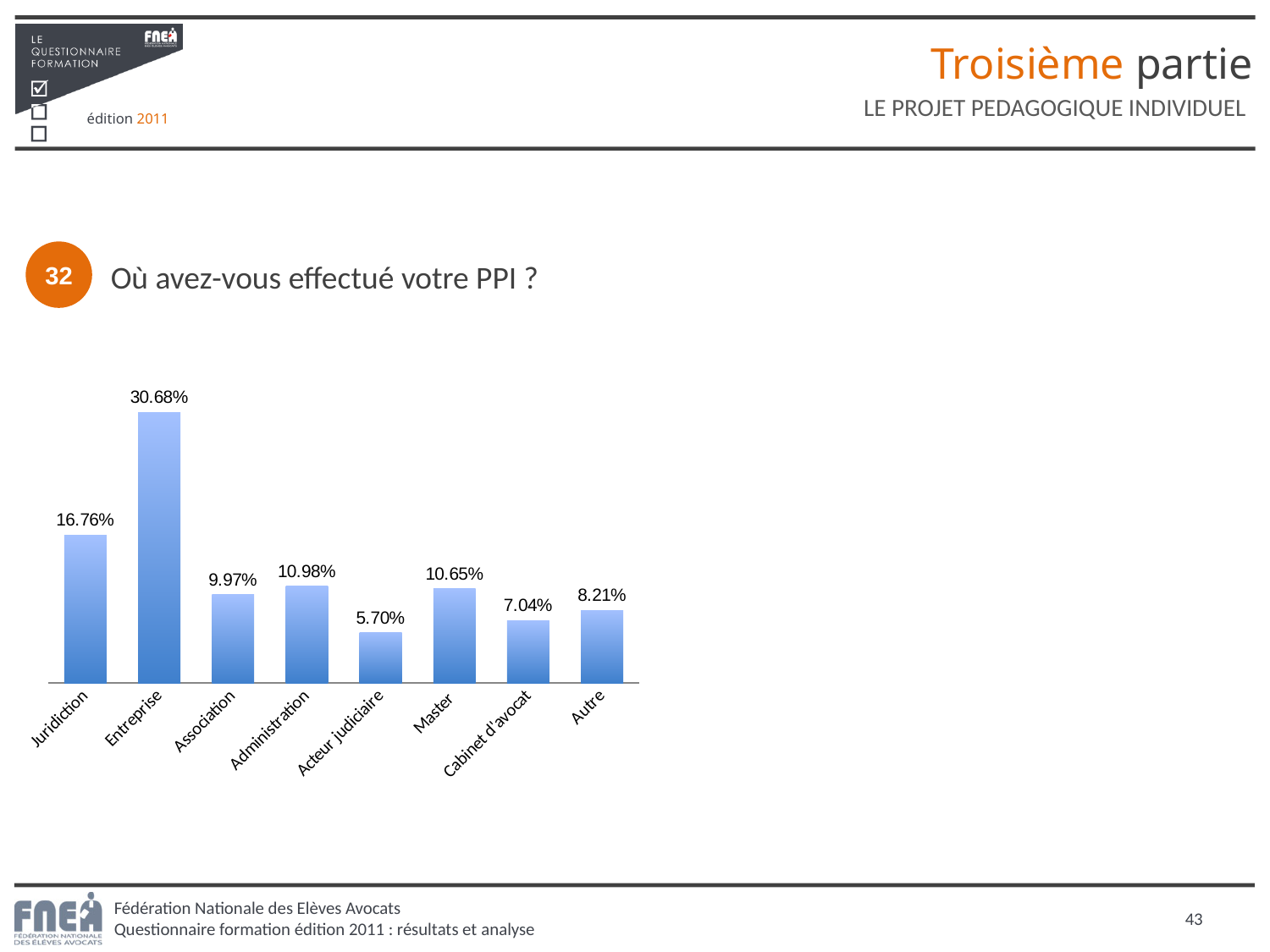
Which category has the lowest value? Acteur judiciaire What kind of chart is shown on the slide? Bar chart What is the value for Acteur judiciaire? 5.70% How many categories are shown on the x axis? 8 What is the difference between the values for Administration and Association? 1.01% What is the value for Juridiction? 16.76% What is the value for Cabinet d'avocat? 7.04% What is the difference between the values for Entreprise and Juridiction? 13.92% What is the value for Entreprise? 30.68% Which is larger, the value for Master or the value for Autre? Master Which category has the highest value? Entreprise What question does the chart answer, as written above it? Où avez-vous effectué votre PPI ?